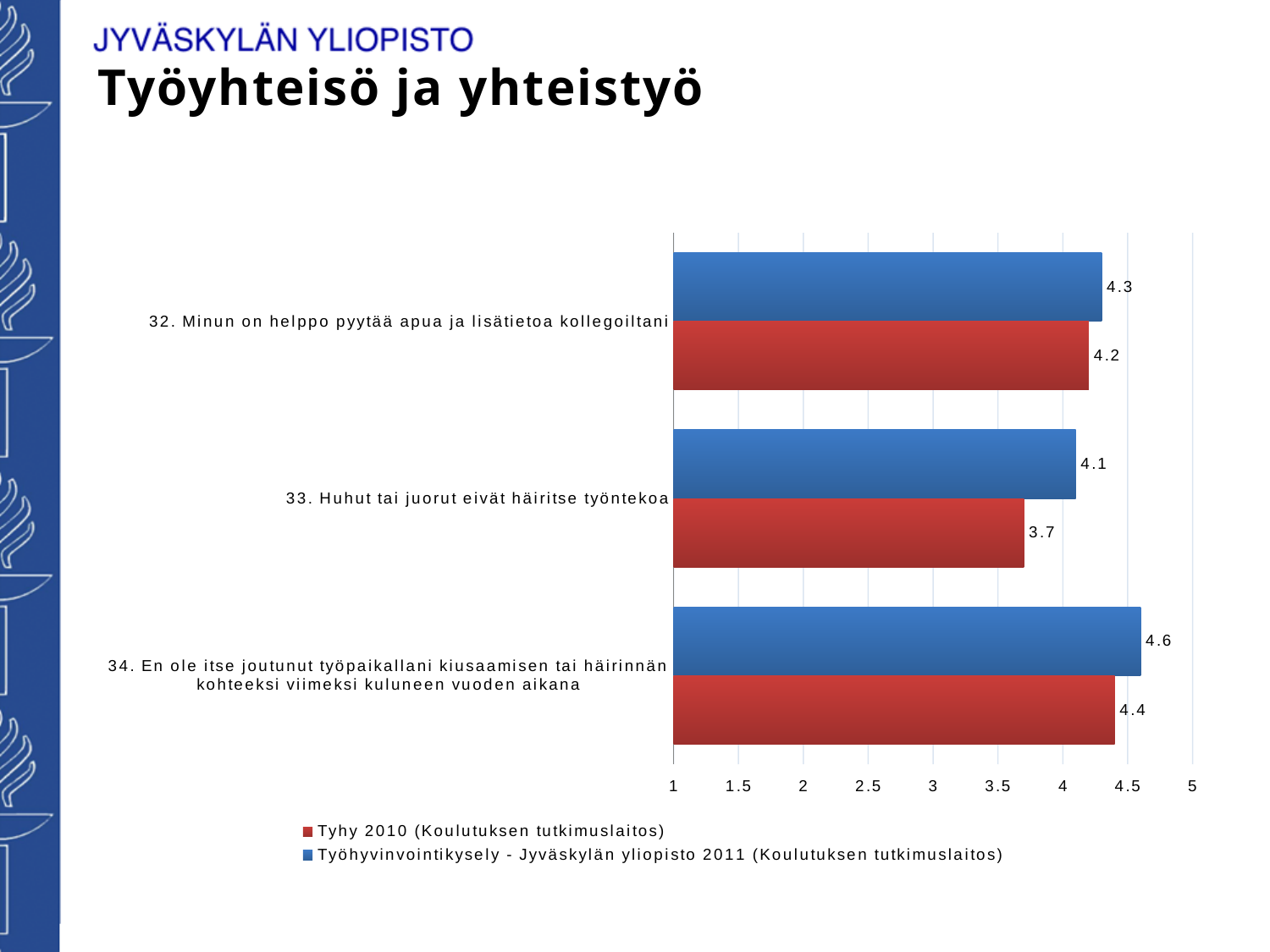
Which statement has the highest value in the Työhyvinvointikysely - Jyväskylän yliopisto 2011 series? 34. En ole itse joutunut työpaikallani kiusaamisen tai häirinnän kohteeksi viimeksi kuluneen vuoden aikana What is the difference between the 2011 and 2010 values for '33. Huhut tai juorut eivät häiritse työntekoa'? 0.4 How many series does the legend list? 2 What is the value for '33. Huhut tai juorut eivät häiritse työntekoa' in the Tyhy 2010 (Koulutuksen tutkimuslaitos) series? 3.7 What is the value for '34. En ole itse joutunut työpaikallani kiusaamisen tai häirinnän kohteeksi viimeksi kuluneen vuoden aikana' in the Työhyvinvointikysely - Jyväskylän yliopisto 2011 series? 4.6 How many categories (statements) are shown in the chart? 3 Which colour represents the Tyhy 2010 (Koulutuksen tutkimuslaitos) series? Red Which statement has the lowest value in the Tyhy 2010 series? 33. Huhut tai juorut eivät häiritse työntekoa For '34. En ole itse joutunut työpaikallani kiusaamisen tai häirinnän kohteeksi viimeksi kuluneen vuoden aikana', which series has the larger value, Tyhy 2010 or Työhyvinvointikysely 2011? Työhyvinvointikysely - Jyväskylän yliopisto 2011 (Koulutuksen tutkimuslaitos) Is the Tyhy 2010 value for '33. Huhut tai juorut eivät häiritse työntekoa' greater or less than 4? less What kind of chart is shown on the slide? Bar chart What is the value for '32. Minun on helppo pyytää apua ja lisätietoa kollegoiltani' in the Tyhy 2010 series? 4.2